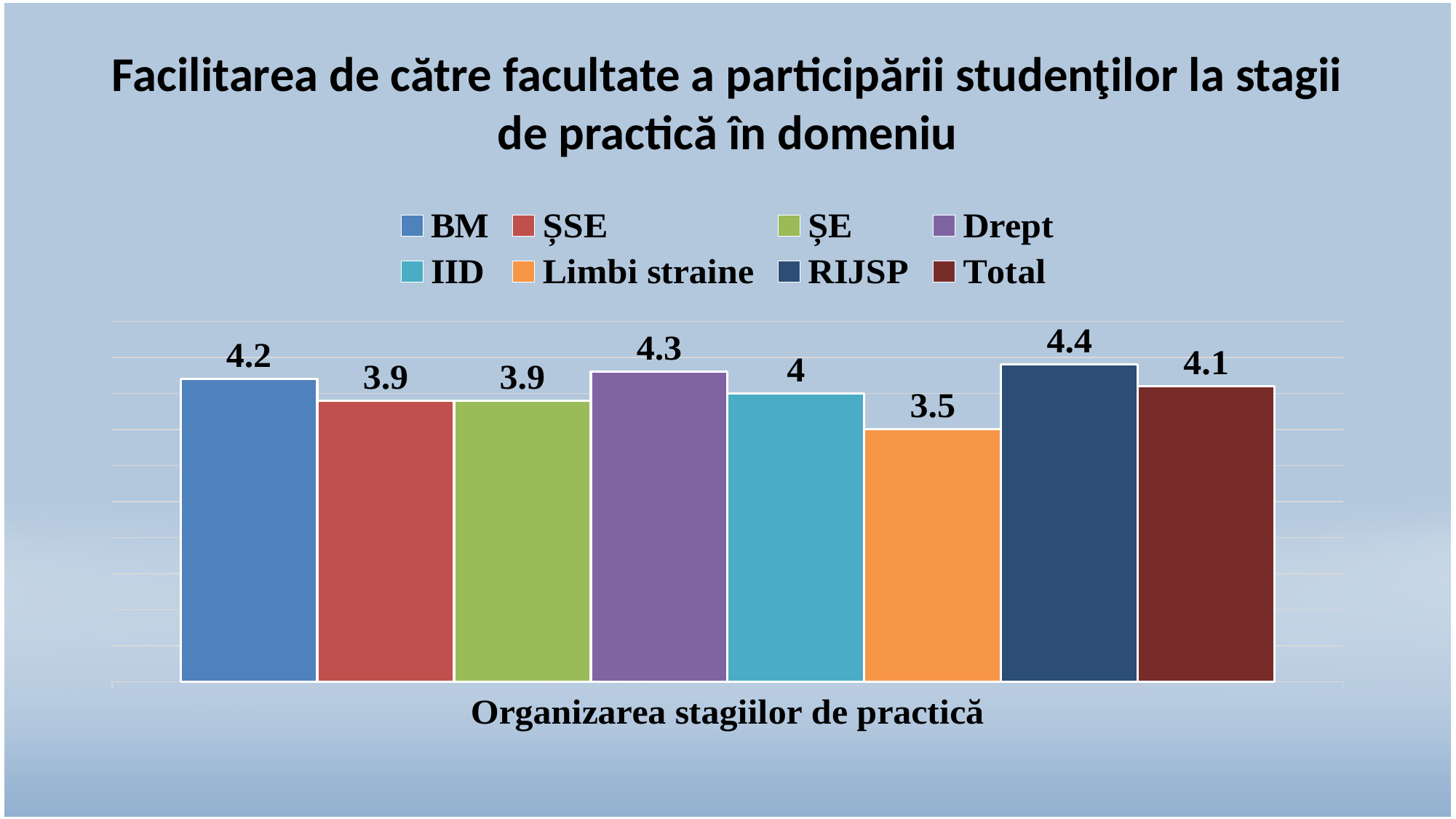
What is the value for Total? 4.1 Which series has the lowest value? Limbi straine What is the value for RIJSP? 4.4 What kind of chart is shown on the slide? Bar chart What is the label on the x axis of the chart? Organizarea stagiilor de practică What is the difference between the values for BM and ȘSE? 0.3 What is the value for IID? 4 What is the difference between the values for RIJSP and Limbi straine? 0.9 What is the value for Limbi straine? 3.5 Which is larger, the value for Drept or the value for BM? Drept How many series does the legend list? 8 Which series has the highest value? RIJSP